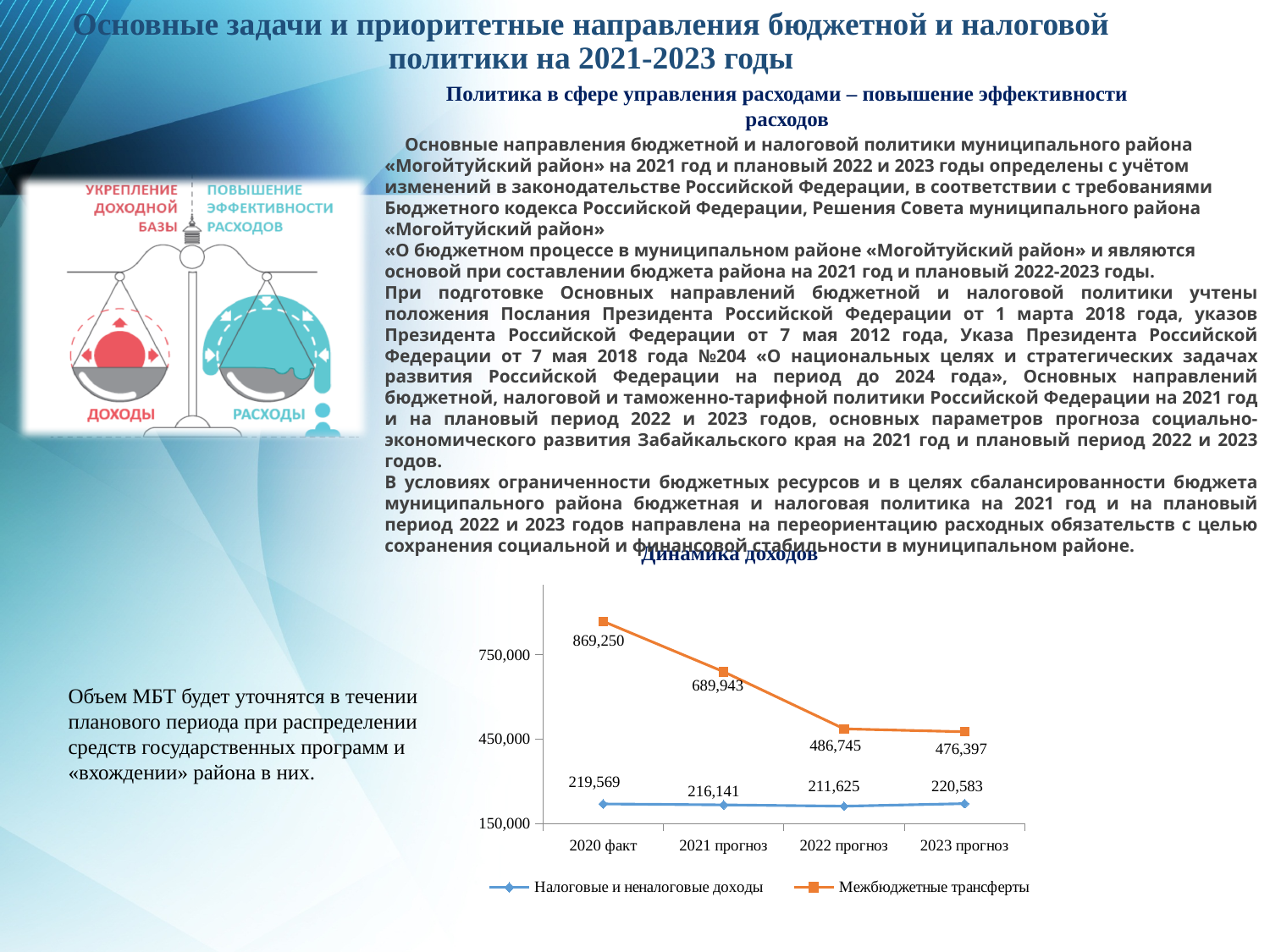
Does «Межбюджетные трансферты» rise or fall from 2020 факт to 2023 прогноз? Fall What is the difference between «Межбюджетные трансферты» in 2020 факт and 2021 прогноз? 179,307 How many series does the chart legend list? 2 Is the value of «Межбюджетные трансферты» for 2022 прогноз greater or less than 450,000? greater Which is larger in 2023 прогноз: «Налоговые и неналоговые доходы» or «Межбюджетные трансферты»? Межбюджетные трансферты What is the value of «Налоговые и неналоговые доходы» for 2022 прогноз? 211,625 What is the value of «Межбюджетные трансферты» for 2023 прогноз? 476,397 What type of chart is shown under the title «Динамика доходов»? Line chart In which period is «Налоговые и неналоговые доходы» lowest? 2022 прогноз How many periods are shown on the x axis of the chart? 4 In which period is «Межбюджетные трансферты» highest? 2020 факт What is the value of «Межбюджетные трансферты» for 2020 факт? 869,250